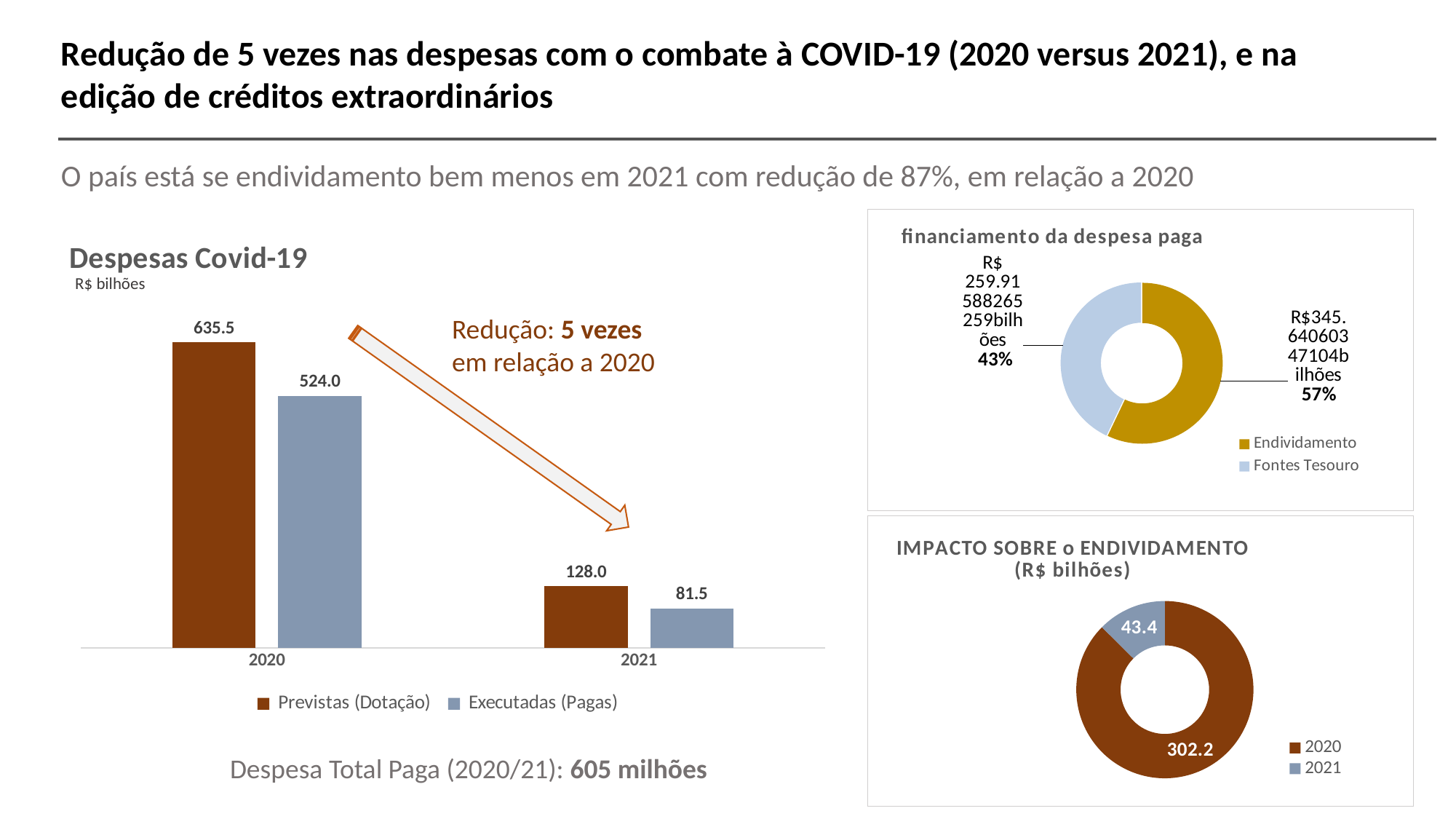
What is the unit shown under the title of the 'Despesas Covid-19' chart? R$ bilhões In the 'Despesas Covid-19' chart, which is larger: Previstas (Dotação) in 2021 or Executadas (Pagas) in 2021? Previstas (Dotação) In the 'financiamento da despesa paga' chart, what share does Endividamento have? 57% In the 'Despesas Covid-19' chart, do the Executadas (Pagas) values rise or fall from 2020 to 2021? Fall In the 'IMPACTO SOBRE o ENDIVIDAMENTO (R$ bilhões)' chart, what is the difference between the 2020 and 2021 values? 258.8 In the 'IMPACTO SOBRE o ENDIVIDAMENTO (R$ bilhões)' chart, what is the value for 2021? 43.4 In the 'Despesas Covid-19' chart, what is the value for Executadas (Pagas) in 2021? 81.5 What kind of chart is 'Despesas Covid-19'? Bar chart In the 'Despesas Covid-19' chart, what is the difference between Previstas (Dotação) and Executadas (Pagas) in 2020? 111.5 In the 'Despesas Covid-19' chart, what is the value for Previstas (Dotação) in 2020? 635.5 In the 'financiamento da despesa paga' chart, which slice is the smallest? Fontes Tesouro In the 'Despesas Covid-19' chart, how many series does the legend list? 2